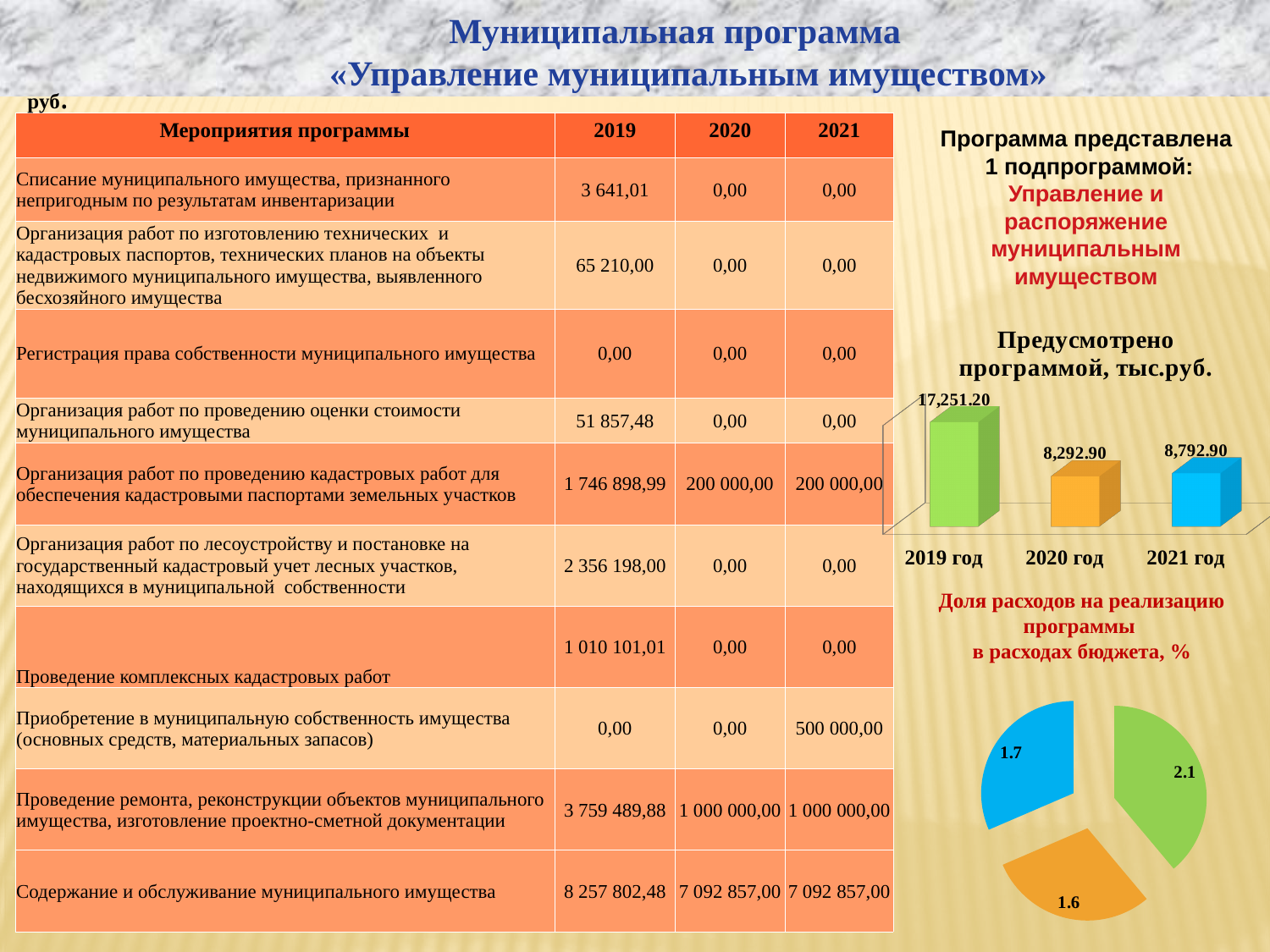
In the bar chart 'Предусмотрено программой, тыс.руб.', what is the value for 2019 год? 17,251.20 In the bar chart 'Предусмотрено программой, тыс.руб.', what is the value for 2020 год? 8,292.90 In the bar chart 'Предусмотрено программой, тыс.руб.', which year has the highest value? 2019 год In the bar chart 'Предусмотрено программой, тыс.руб.', which year has the lowest value? 2020 год In the pie chart 'Доля расходов на реализацию программы в расходах бюджета, %', what value is shown on the green slice? 2.1 What type of chart is used for 'Доля расходов на реализацию программы в расходах бюджета, %'? pie chart In the bar chart 'Предусмотрено программой, тыс.руб.', what is the value for 2021 год? 8,792.90 In the bar chart 'Предусмотрено программой, тыс.руб.', what is the difference between the values for 2019 год and 2021 год? 8,458.30 In the pie chart 'Доля расходов на реализацию программы в расходах бюджета, %', how many slices are there? 3 In the bar chart 'Предусмотрено программой, тыс.руб.', is the value for 2021 год larger or smaller than the value for 2020 год? larger What type of chart is used for 'Предусмотрено программой, тыс.руб.'? bar chart How many bars are shown in the bar chart 'Предусмотрено программой, тыс.руб.'? 3